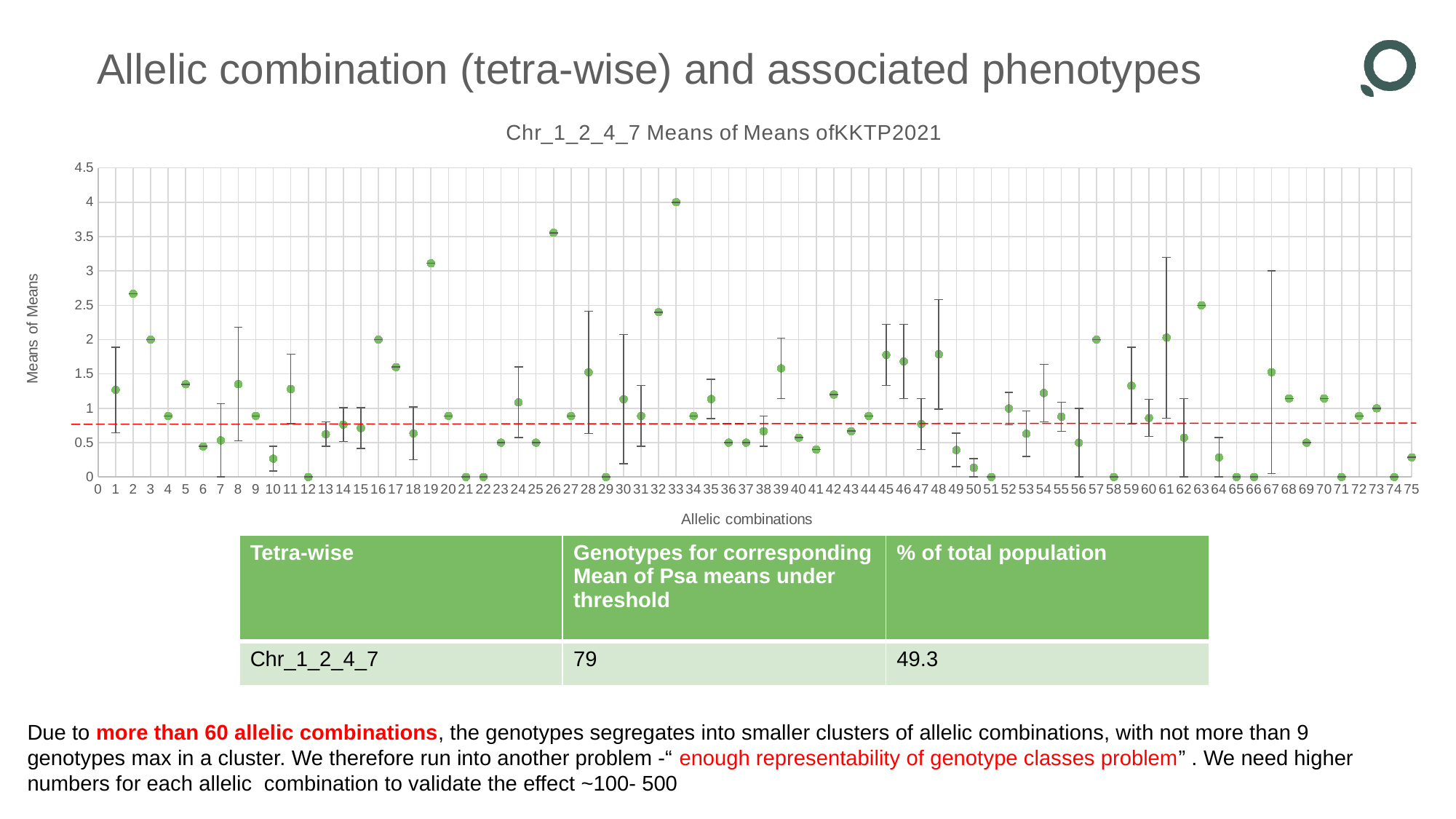
Which has the larger Means of Means value, allelic combination 26 or allelic combination 19? 26 What is the Means of Means value for allelic combination 33? 4 What is the Means of Means value for allelic combination 12? 0 Is the value for allelic combination 10 greater or less than 0.5? less What kind of chart is shown on the slide? Scatter chart Is the value for allelic combination 26 greater or less than 3? greater Is the value for allelic combination 63 greater or less than 2? greater What is the title of the chart? Chr_1_2_4_7 Means of Means ofKKTP2021 Which has the larger Means of Means value, allelic combination 2 or allelic combination 3? 2 Which allelic combination has the highest Means of Means value? 33 What is the label of the y axis of the chart? Means of Means